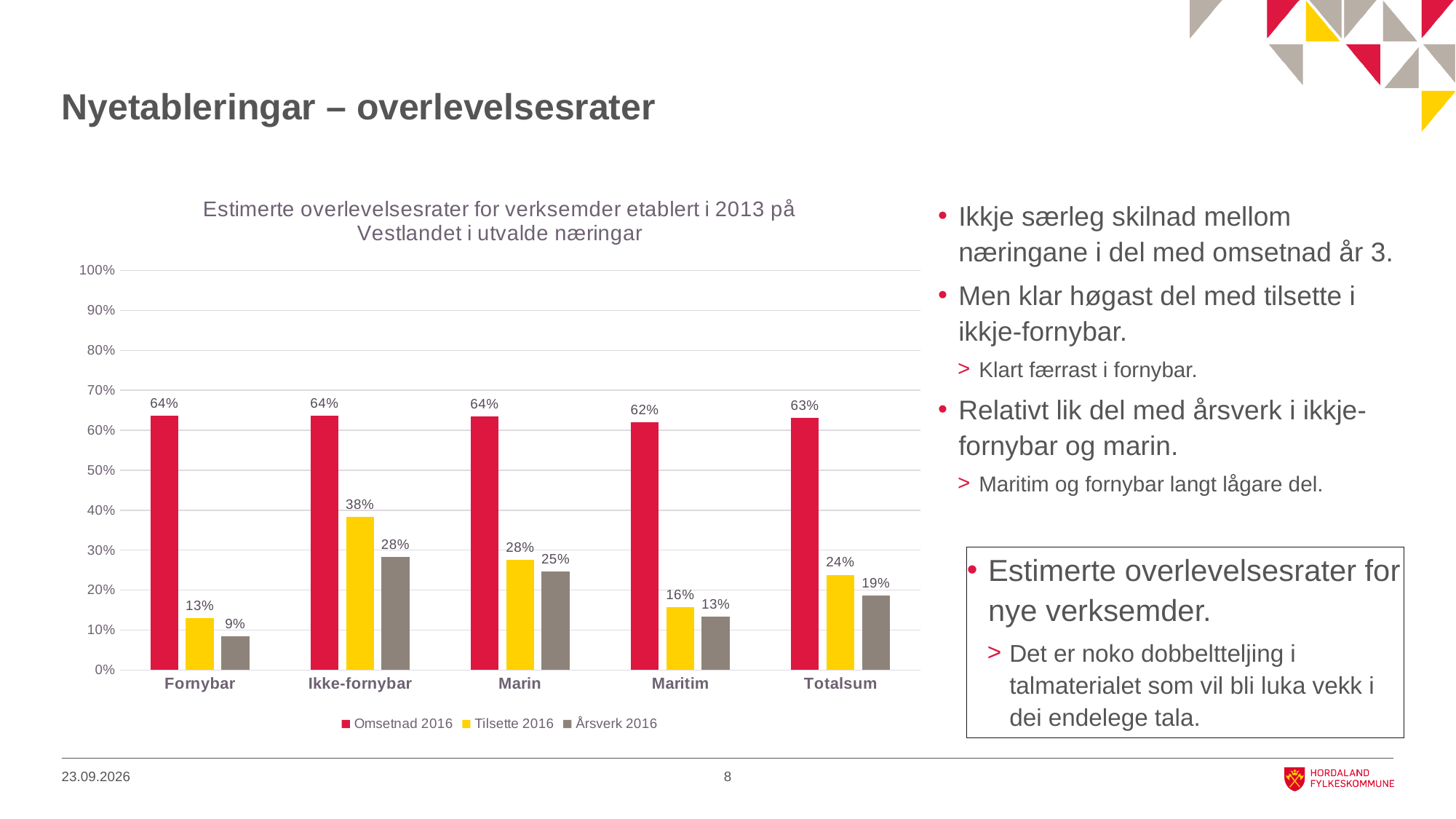
Which category has the highest value for Tilsette 2016? Ikke-fornybar What kind of chart is shown on the slide? Bar chart How many categories are shown on the x axis? 5 What is the value for Tilsette 2016 in the Totalsum category? 24% What is the value for Omsetnad 2016 in the Maritim category? 62% Which is larger: the Årsverk 2016 value for Marin or for Maritim? Marin Which series is shown in yellow in the legend? Tilsette 2016 Which category has the lowest value for Årsverk 2016? Fornybar What is the value for Tilsette 2016 in the Ikke-fornybar category? 38% What is the value for Årsverk 2016 in the Fornybar category? 9% What is the difference between the Tilsette 2016 values for Ikke-fornybar and Fornybar? 25% How many series does the legend list? 3